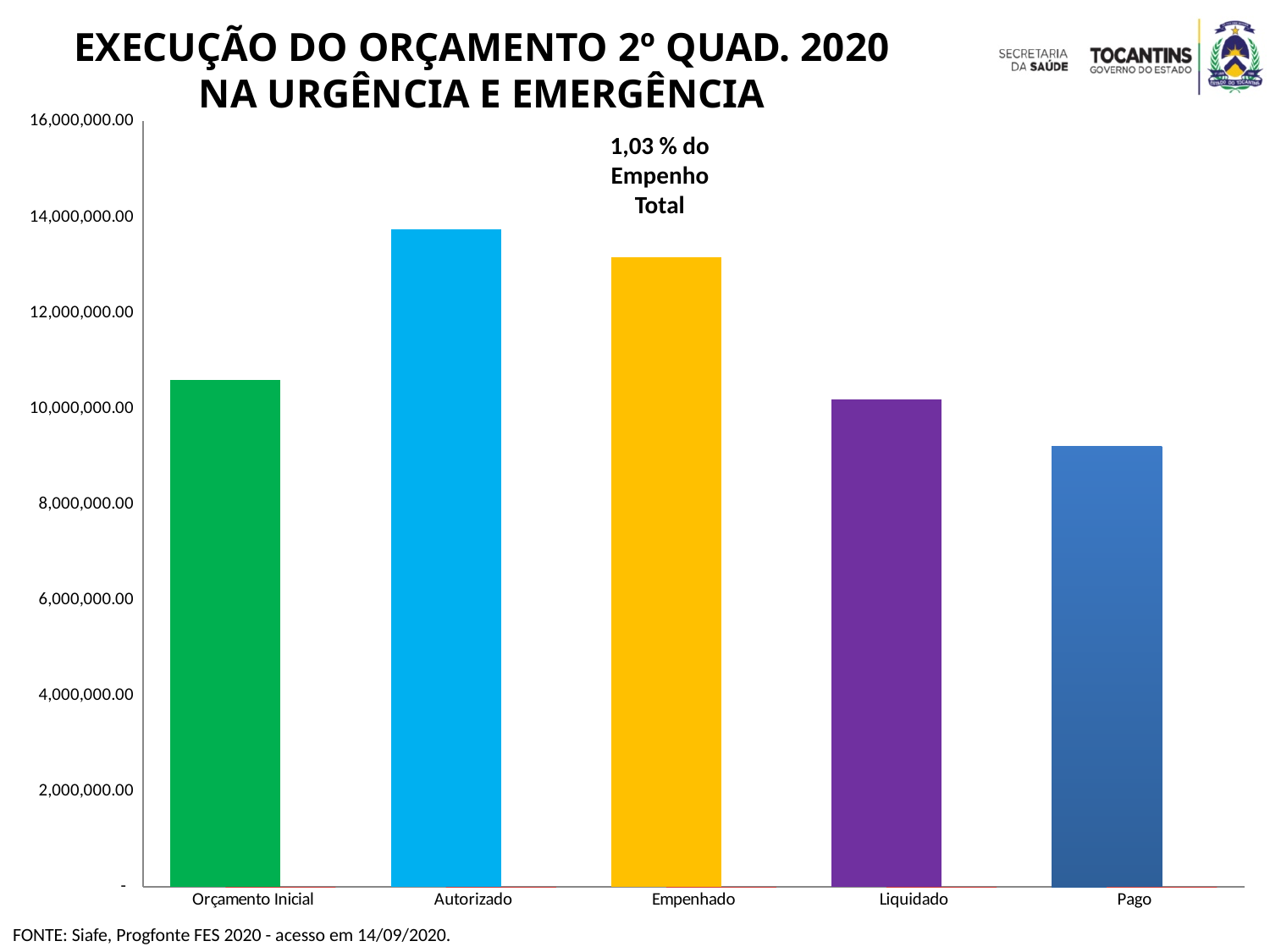
Which is larger, the value for Liquidado or the value for Pago? Liquidado Which category has the highest bar in the chart? Autorizado What is the title of the chart on the slide? EXECUÇÃO DO ORÇAMENTO 2º QUAD. 2020 NA URGÊNCIA E EMERGÊNCIA Is the value for Autorizado greater or less than 14,000,000.00? less Is the value for Orçamento Inicial greater or less than 10,000,000.00? greater Is the value for Empenhado greater or less than 12,000,000.00? greater Which is larger, the value for Autorizado or the value for Empenhado? Autorizado What text annotation appears above the Empenhado bar? 1,03 % do Empenho Total How many categories are shown on the x axis of the chart? 5 Which category has the lowest bar in the chart? Pago What kind of chart is shown on the slide? Bar chart